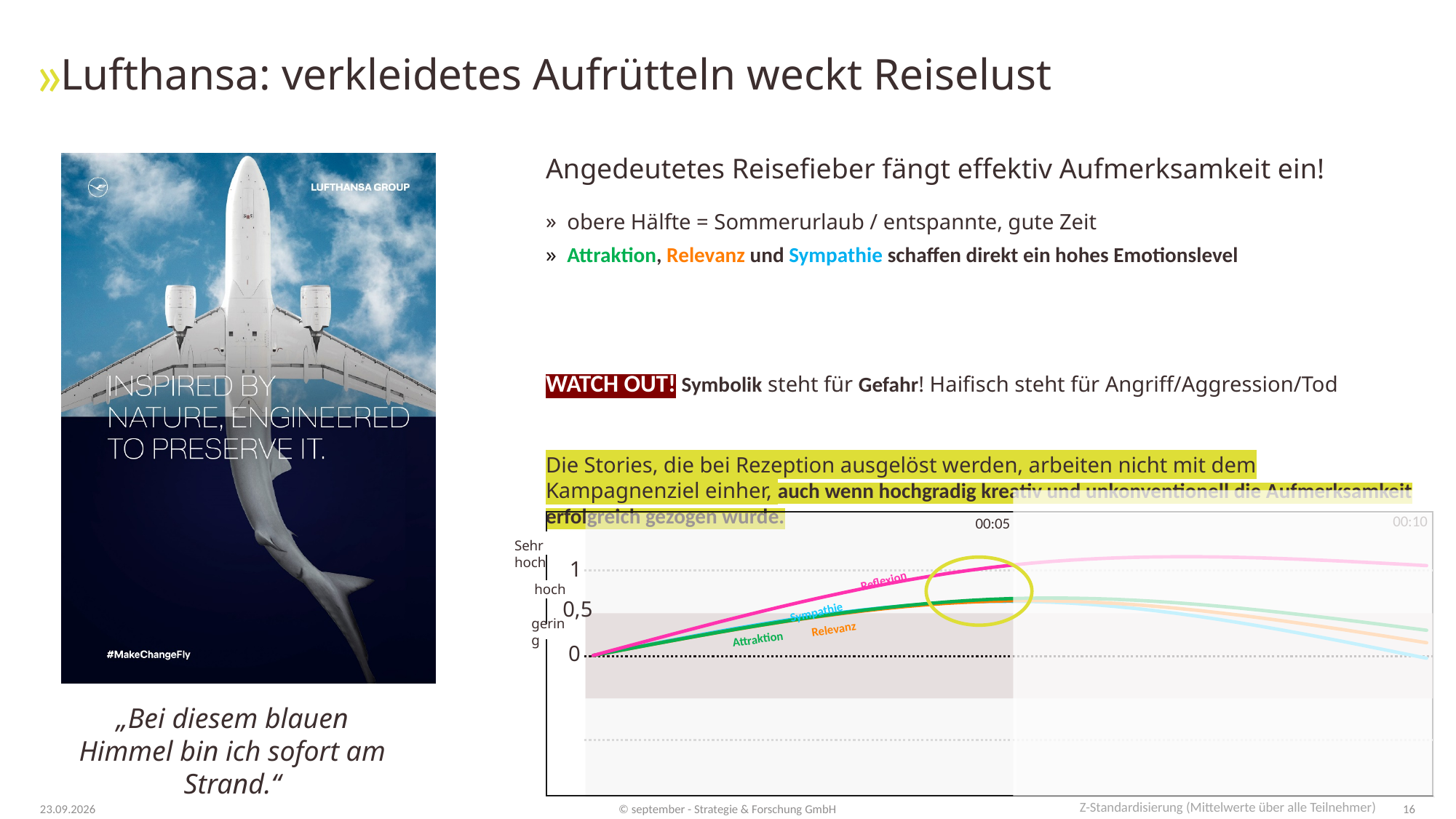
Is the value of the Reflexion line at 00:05 greater or less than 0.5? greater At 00:05, which line is higher: Reflexion or Sympathie? Reflexion Do the lines on the chart rise or fall between the start and 00:05? rise Which series reaches the highest value on the line chart? Reflexion What kind of chart is shown at the bottom right of the slide? line chart What time labels are shown along the top of the line chart? 00:05 and 00:10 How many series are labelled on the line chart? 4 What are the numeric tick values shown on the y axis of the line chart? 0, 0,5, 1 Do the lines on the chart rise or fall after 00:05? fall Is the value of the Relevanz line at 00:05 greater or less than 0? greater Is the value of the Attraktion line at 00:05 greater or less than 1? less